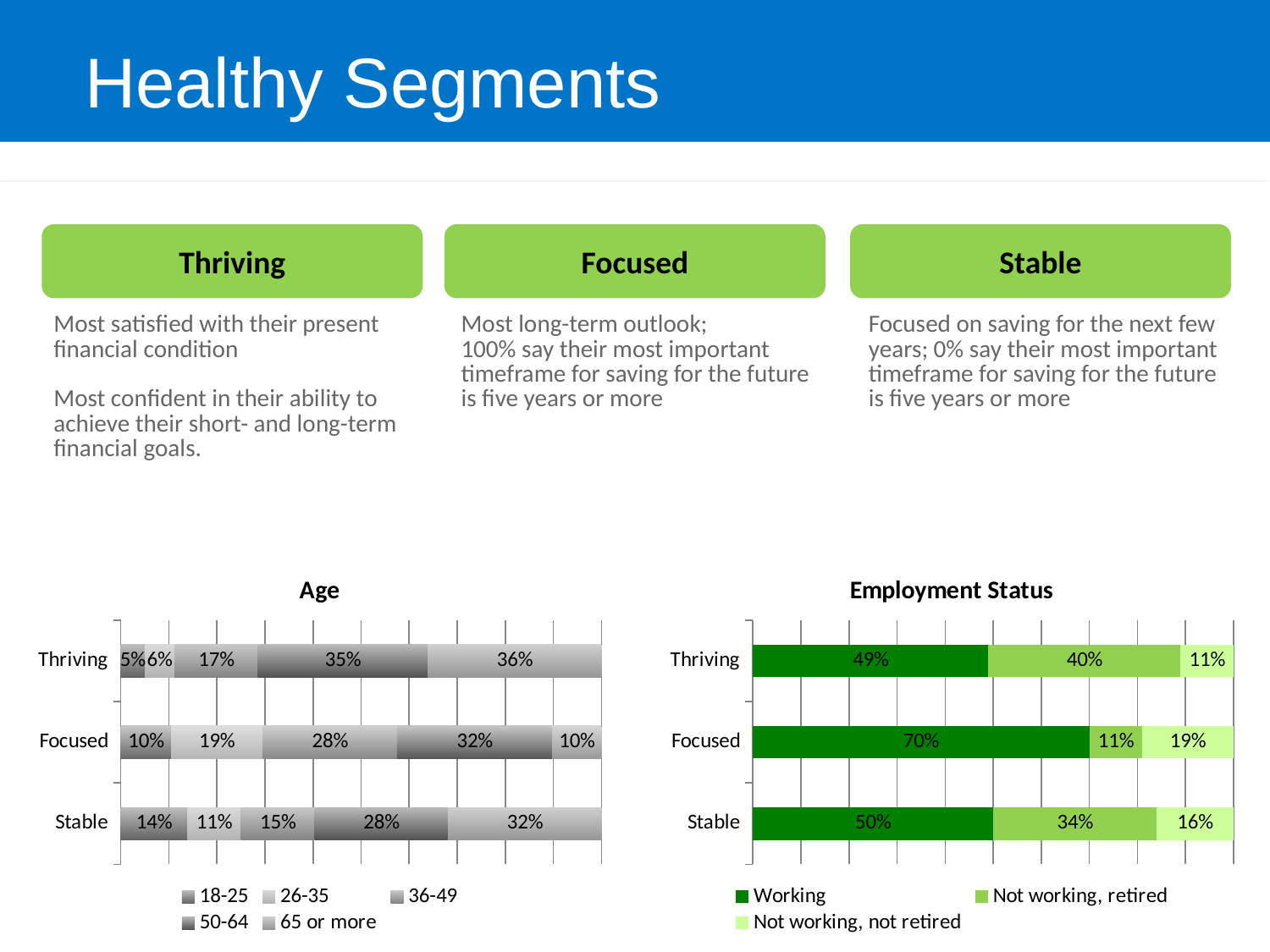
In the Age chart, how many segments (categories) are shown? 3 In the Employment Status chart, which segment has the highest Working percentage? Focused In the Age chart, is the 36-49 share larger for Focused or for Stable? Focused In the Employment Status chart, how many series does the legend list? 3 What type of chart is the Age chart? Stacked bar chart In the Age chart, which segment has the largest 65 or more share? Thriving In the Employment Status chart, what is the difference between the Working percentages for Focused and Stable? 20% In the Employment Status chart, which segment has the lowest Not working, not retired percentage? Thriving In the Employment Status chart, what percentage of the Thriving segment is Working? 49% In the Employment Status chart, what percentage of the Focused segment is Not working, retired? 11% In the Age chart, what percentage of the Focused segment is 50-64? 32% In the Age chart, what percentage of the Stable segment is 65 or more? 32%